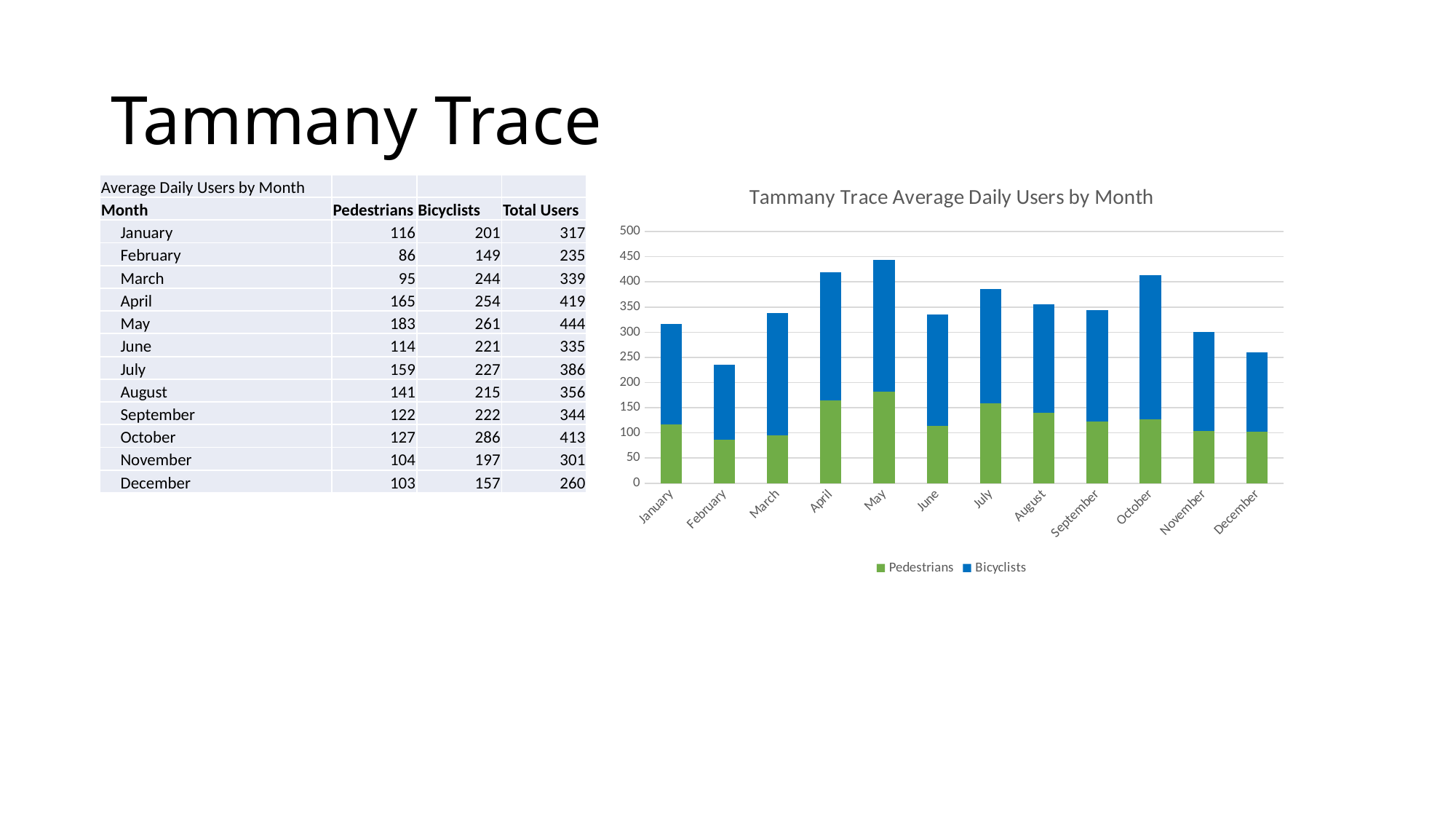
What is the Pedestrians value for May? 183 What is the difference between the Total Users for May and February? 209 What is the Bicyclists value for March? 244 Which month has the lowest total bar in the chart? February How many months are plotted on the x axis of the chart? 12 Which month has the highest total bar in the chart? May How many series does the chart legend list? 2 Is the total bar for November greater or less than 350? less What is the total number of average daily users for October? 413 What kind of chart is shown on the slide? Stacked bar chart Which is larger, the total bar for April or the total bar for July? April Which colour represents Bicyclists in the chart? Blue